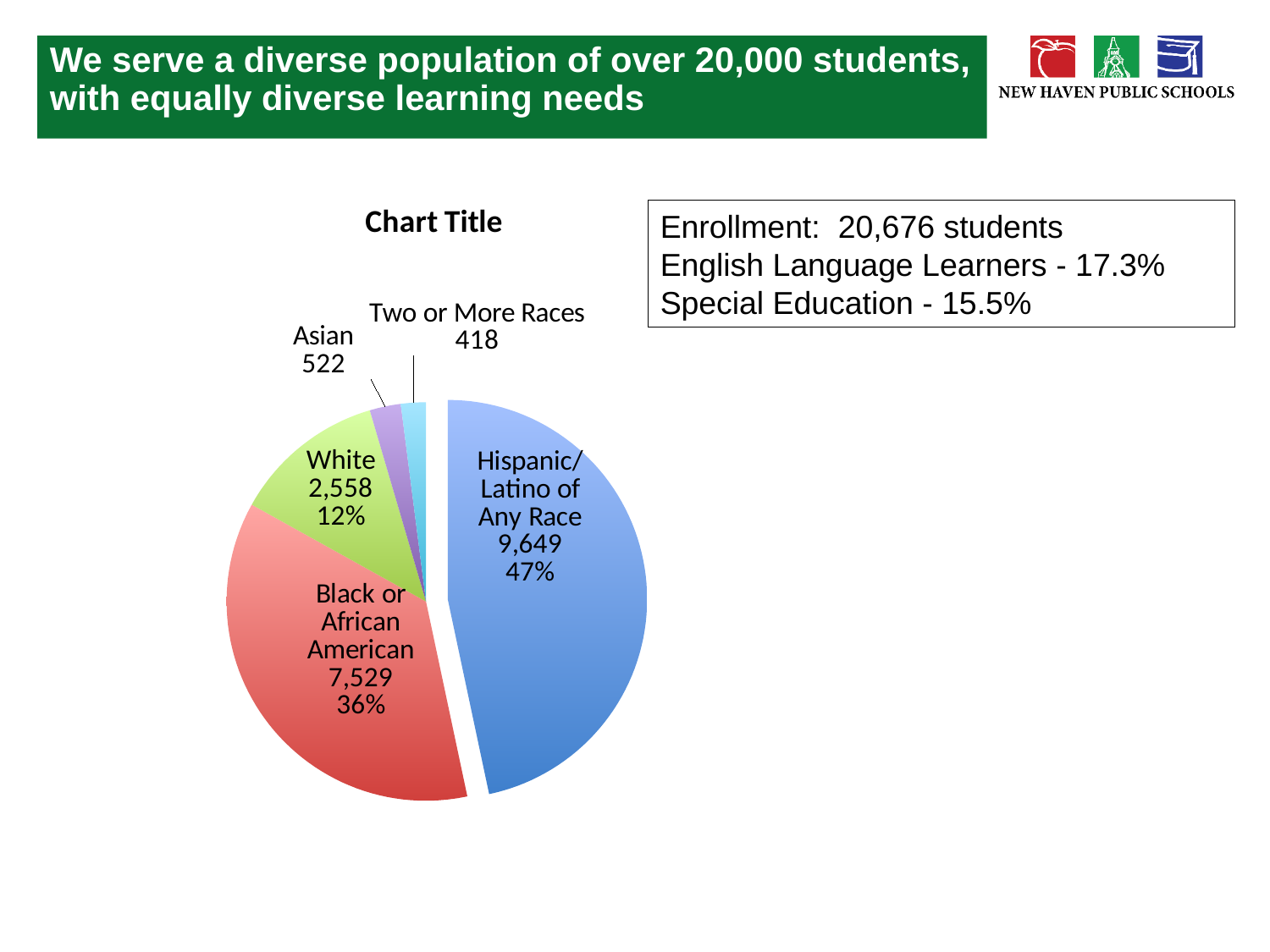
Which category has the largest slice? Hispanic/Latino of Any Race What is the value for Hispanic/Latino of Any Race? 9,649 What is the value for Two or More Races? 418 Which is larger, the value for Asian or the value for Two or More Races? Asian What is the value for White? 2,558 What is the value for Asian? 522 What is the value for Black or African American? 7,529 How many slices does the pie chart have? 5 What share of the pie does the White slice represent? 12% What is the difference between the Hispanic/Latino of Any Race value and the Black or African American value? 2,120 Which category has the smallest slice? Two or More Races What kind of chart is shown on the slide? Pie chart